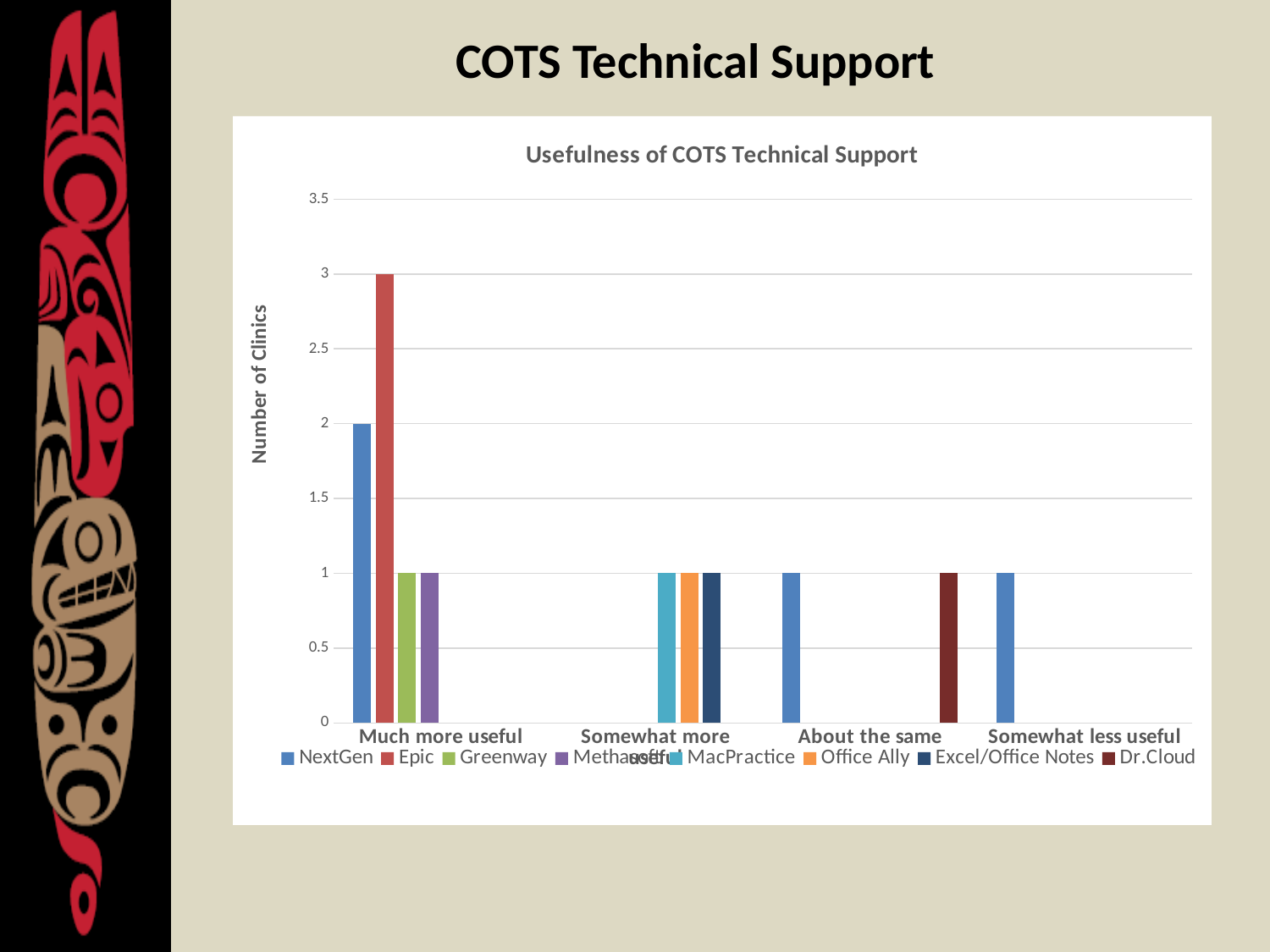
What is the difference between Epic and NextGen in the 'Much more useful' category? 1 Which series has the highest bar in the 'Much more useful' category? Epic What is the value for Greenway in the 'Much more useful' category? 1 What is the chart's title? Usefulness of COTS Technical Support What is the label of the y axis? Number of Clinics What is the value for Dr.Cloud in the 'About the same' category? 1 What is the value for NextGen in the 'Much more useful' category? 2 How many series does the legend list? 8 Which is larger in the 'Much more useful' category, NextGen or Greenway? NextGen How many categories are shown on the x axis? 4 What type of chart is shown on the slide? bar chart What is the value for Epic in the 'Much more useful' category? 3